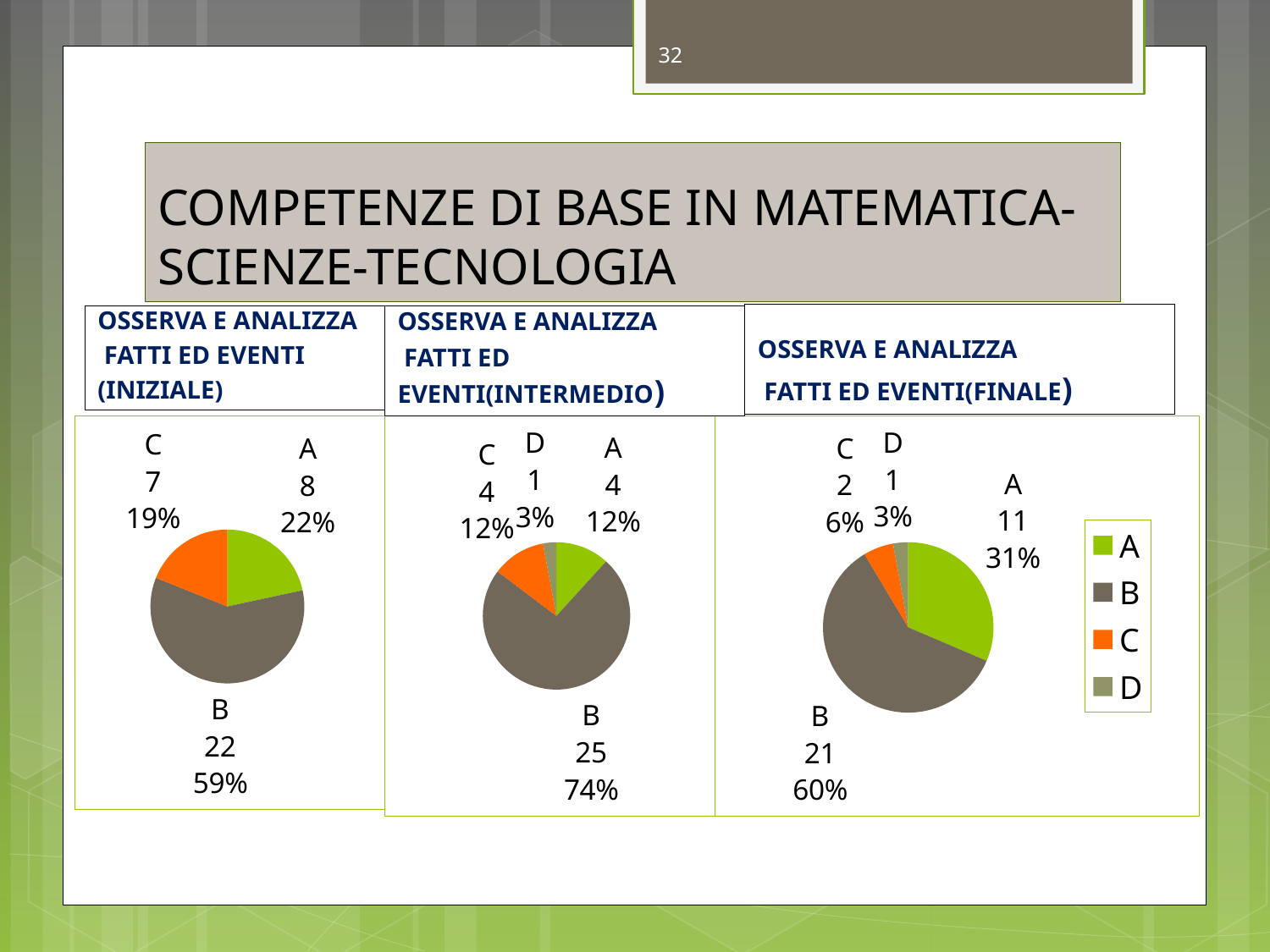
In the right pie chart (FINALE), which is larger, the value for A or the value for C? A How many categories are shown in the middle pie chart (INTERMEDIO)? 4 In the middle pie chart (INTERMEDIO), what value is shown for category D? 1 In the right pie chart (FINALE), what value is shown for category A? 11 In the left pie chart (INIZIALE), what percentage share does category C have? 19% In the left pie chart (INIZIALE), what value is shown for category B? 22 What type of chart is used on this slide? Pie chart In the right pie chart (FINALE), what percentage share does category C have? 6% In the middle pie chart (INTERMEDIO), which category has the smallest slice? D In the left pie chart (INIZIALE), what is the difference between the values for B and A? 14 In the right pie chart (FINALE), which category has the largest slice? B In the middle pie chart (INTERMEDIO), what percentage share does category B have? 74%